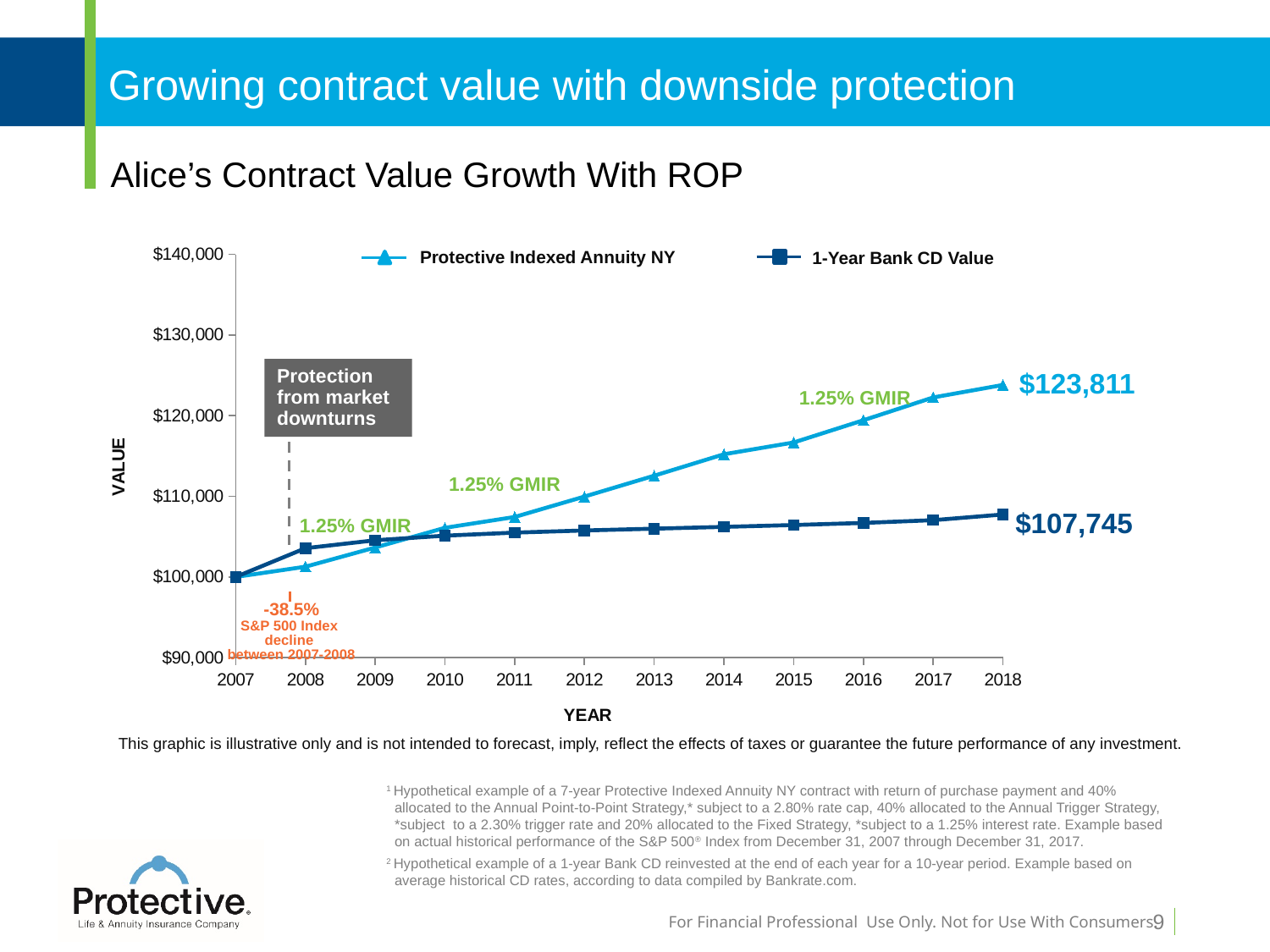
How many series does the chart's legend list? 2 What is the value of Protective Indexed Annuity NY in 2018? $123,811 What kind of chart is shown on the slide? Line chart Which series has the higher value in 2018, Protective Indexed Annuity NY or 1-Year Bank CD Value? Protective Indexed Annuity NY Is the value for Protective Indexed Annuity NY in 2014 greater or less than $110,000? greater What is the difference between the 2018 values of Protective Indexed Annuity NY and the 1-Year Bank CD Value? $16,066 How many years are shown on the x axis of the chart? 12 Is the value for Protective Indexed Annuity NY in 2009 greater or less than $110,000? less What is the title of the chart? Alice's Contract Value Growth With ROP Is the 1-Year Bank CD Value in 2012 greater or less than $110,000? less What is the 1-Year Bank CD Value in 2018? $107,745 Does the 1-Year Bank CD Value rise or fall from 2007 to 2018? Rise